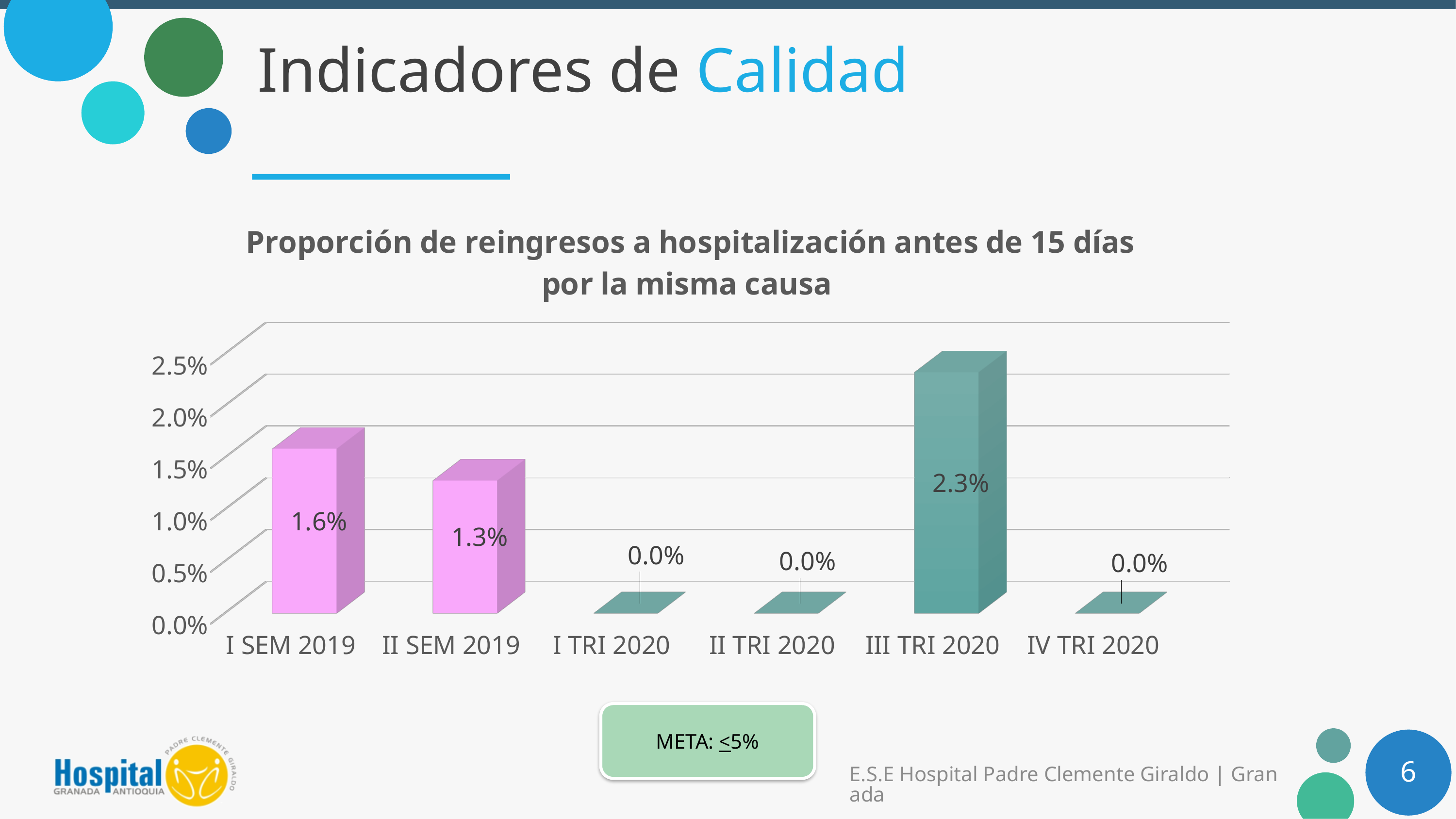
What is the difference between the values for III TRI 2020 and I SEM 2019? 0.7% Which category has the highest value? III TRI 2020 What kind of chart is shown on the slide? bar chart Is the value for III TRI 2020 greater or less than 2.0%? greater What is the value for III TRI 2020? 2.3% What is the value for I SEM 2019? 1.6% How many categories are shown on the x axis? 6 What is the value for II SEM 2019? 1.3% What is the title of the chart? Proporción de reingresos a hospitalización antes de 15 días por la misma causa Which is larger, the value for I SEM 2019 or the value for II SEM 2019? I SEM 2019 What is the difference between the values for I SEM 2019 and II SEM 2019? 0.3% What is the value for II TRI 2020? 0.0%